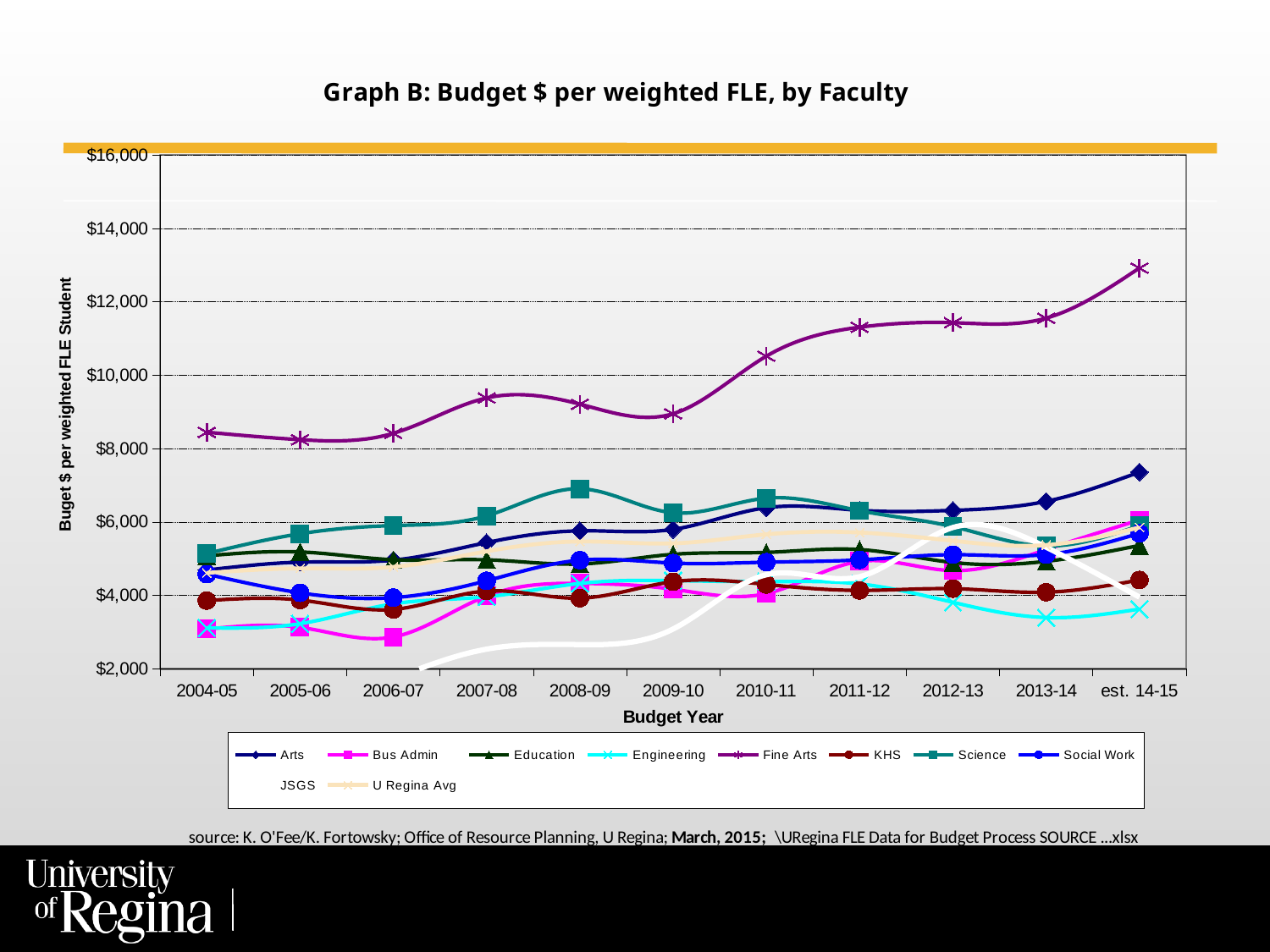
In 2013-14, which is larger: the value for Fine Arts or the value for Arts? Fine Arts Is the value for Arts in est. 14-15 greater or less than $6,000? greater Which faculty has the highest budget $ per weighted FLE student in est. 14-15? Fine Arts What is the label on the y axis of the chart? Buget $ per weighted FLE Student What kind of chart is shown on the slide? line chart How many budget years are plotted along the x axis? 11 Is the value for Engineering in 2004-05 greater or less than $4,000? less Is the value for Fine Arts in 2004-05 greater or less than $8,000? greater Does the Fine Arts line generally rise or fall from 2004-05 to est. 14-15? rise How many series does the legend list? 10 Which faculty has the lowest budget $ per weighted FLE student in 2013-14? Engineering